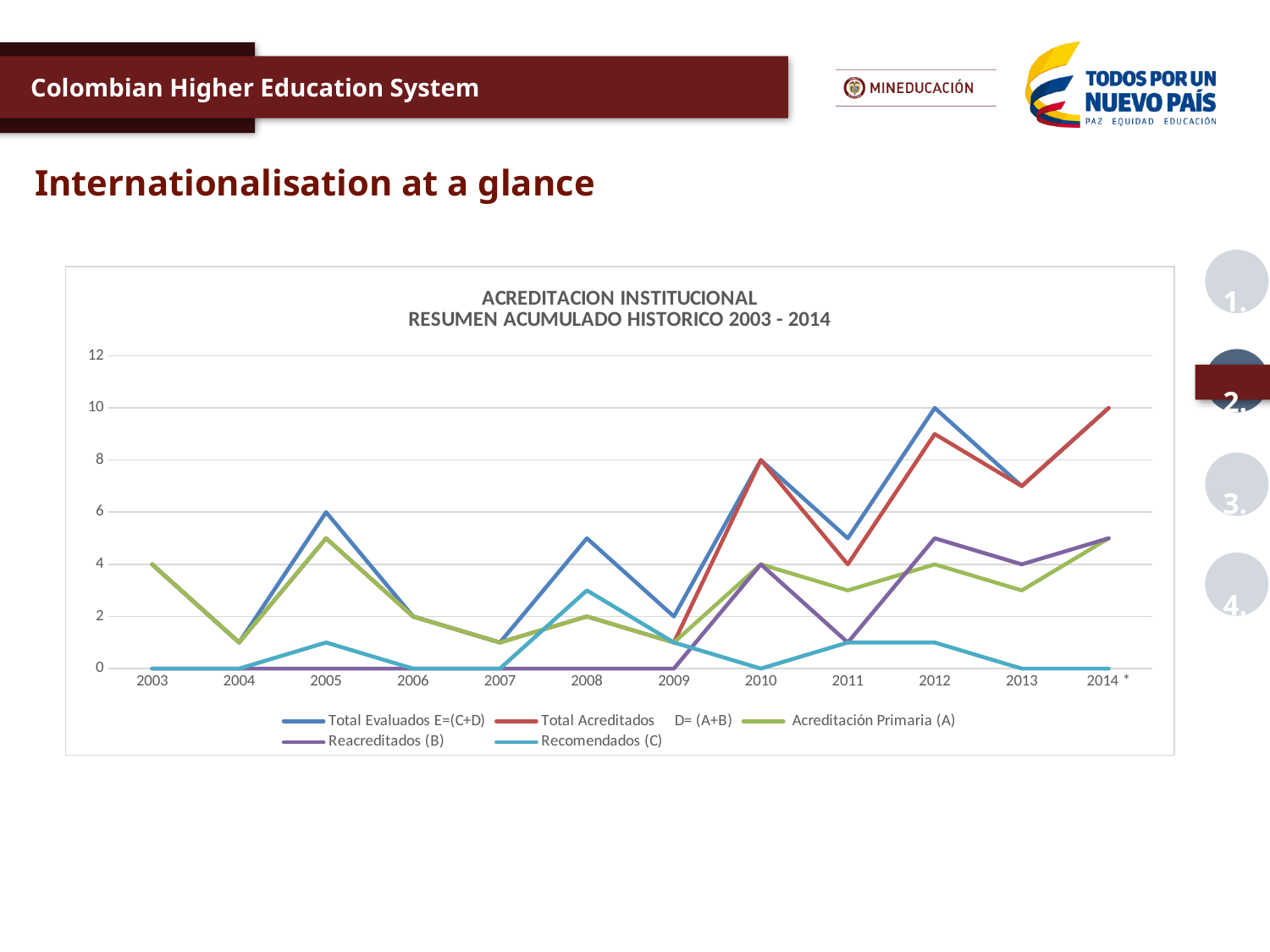
Is the value for Total Evaluados E=(C+D) in 2013 greater or less than 6? greater What is the value of Reacreditados (B) in 2010? 4 What kind of chart is shown on the slide? line chart Is the value for Recomendados (C) in 2008 greater or less than 4? less What is the difference between Total Evaluados E=(C+D) in 2012 and in 2010? 2 What is the value of Total Evaluados E=(C+D) in 2012? 10 How many series does the legend list? 5 What is the value of Total Evaluados E=(C+D) in 2010? 8 What is the value of Total Acreditados D= (A+B) in 2014 *? 10 In 2010, which is larger: Reacreditados (B) or Recomendados (C)? Reacreditados (B) In which year does Total Acreditados D= (A+B) reach its highest value? 2014 * How many years are shown along the x axis? 12